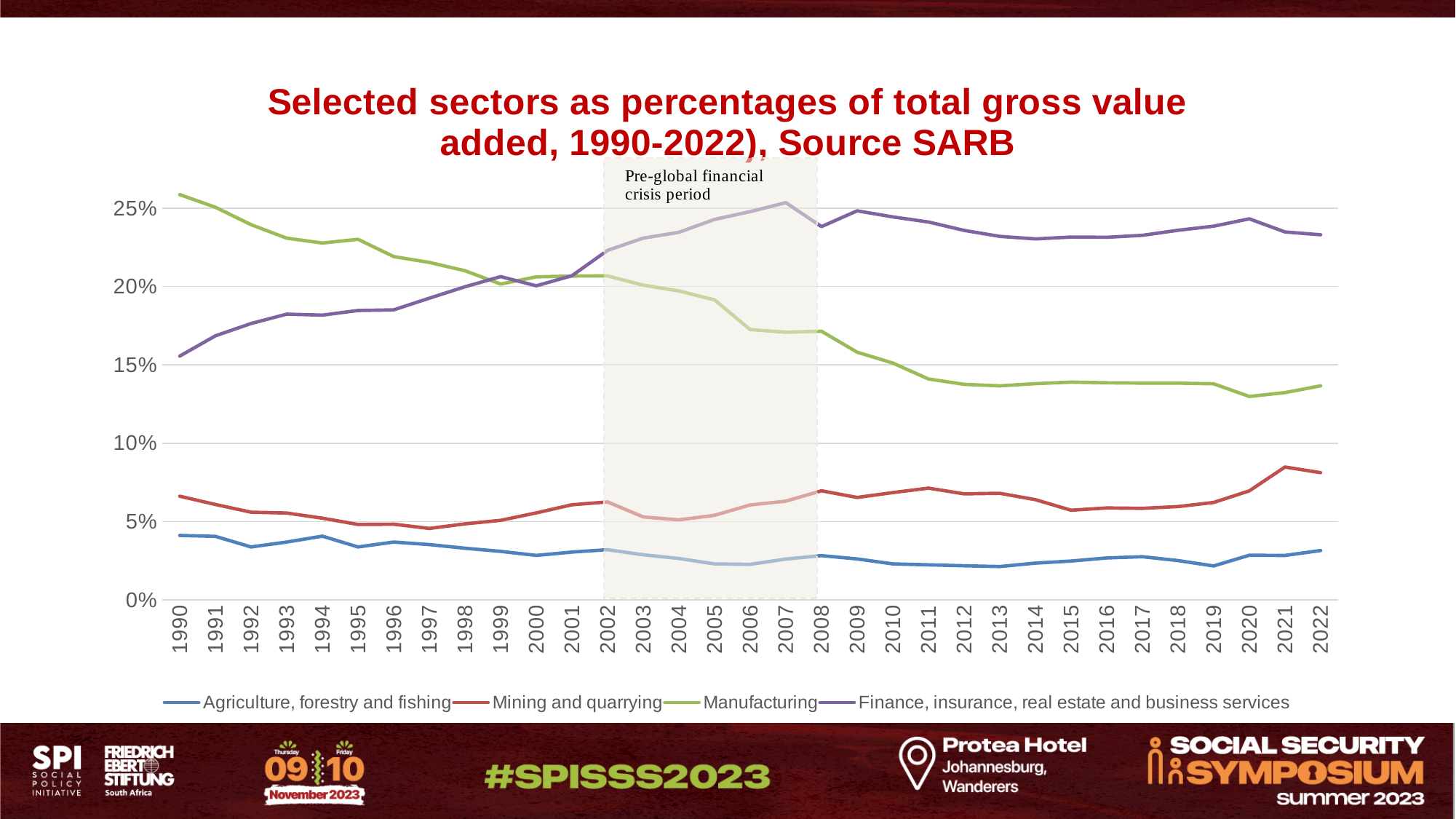
What label is written on the shaded region of the chart? Pre-global financial crisis period Does the Manufacturing line rise or fall overall from 1990 to 2022? fall Is the value for Finance, insurance, real estate and business services in 1990 greater or less than 20%? less What kind of chart is shown on the slide? line chart How many series does the legend list? 4 Is the value for Manufacturing in 1990 greater or less than 25%? greater Is the value for Mining and quarrying in 2021 greater or less than 10%? less Which sector has the lowest value in 2022? Agriculture, forestry and fishing How many years are shown along the x axis? 33 In 2022, which is larger: Finance, insurance, real estate and business services or Manufacturing? Finance, insurance, real estate and business services